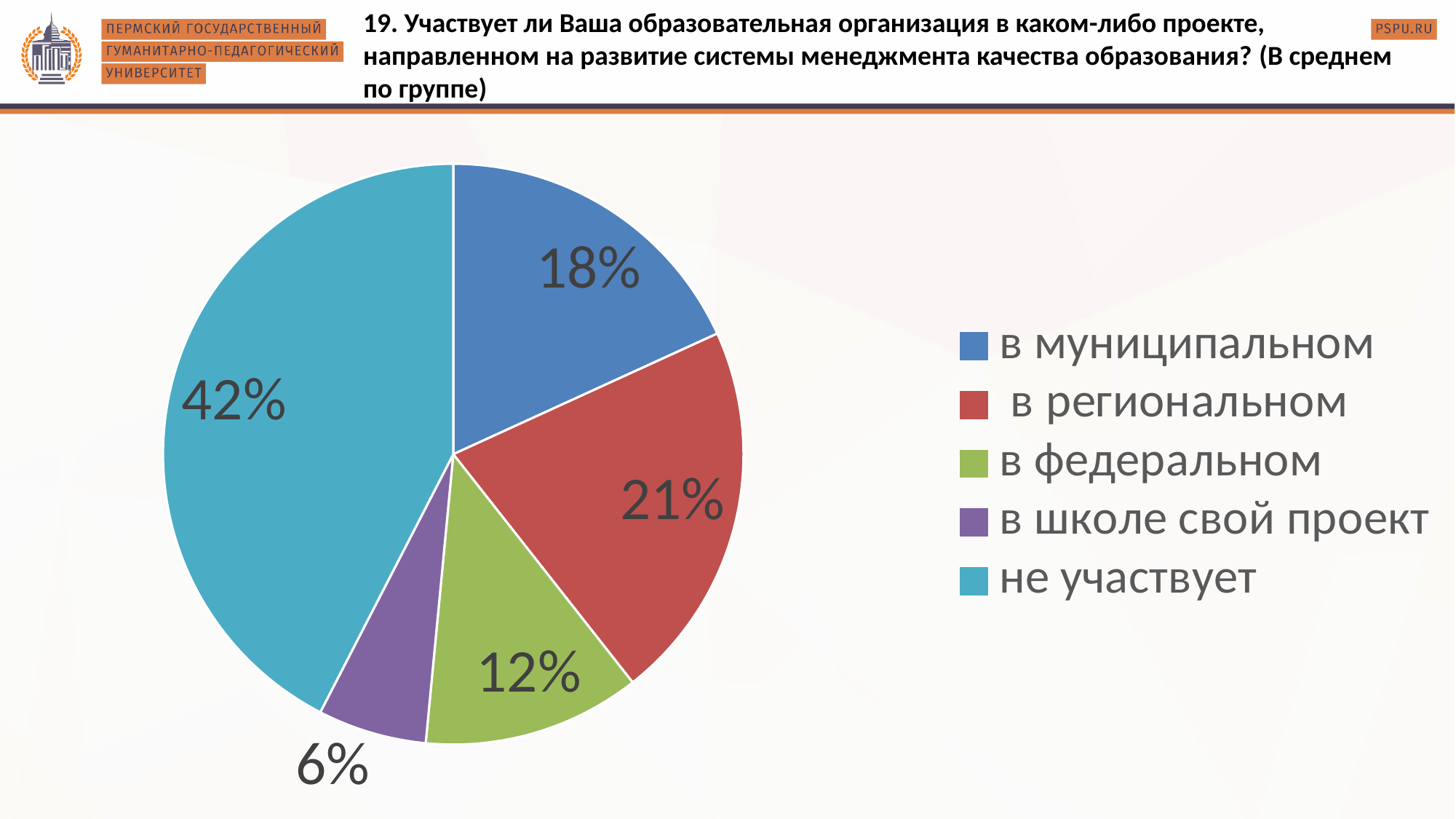
What colour is the slice for "в федеральном"? green What is the value for "в школе свой проект"? 6% What is the value for "в федеральном"? 12% Which category has the smallest slice of the pie? в школе свой проект Which is larger, the value for "в региональном" or the value for "в муниципальном"? в региональном What kind of chart is shown on the slide? pie chart How many categories does the legend list? 5 Which category has the largest slice of the pie? не участвует What is the value for "в муниципальном"? 18% What is the value for "в региональном"? 21% What share of the pie is labelled "не участвует"? 42% What is the difference between the values for "не участвует" and "в региональном"? 21%